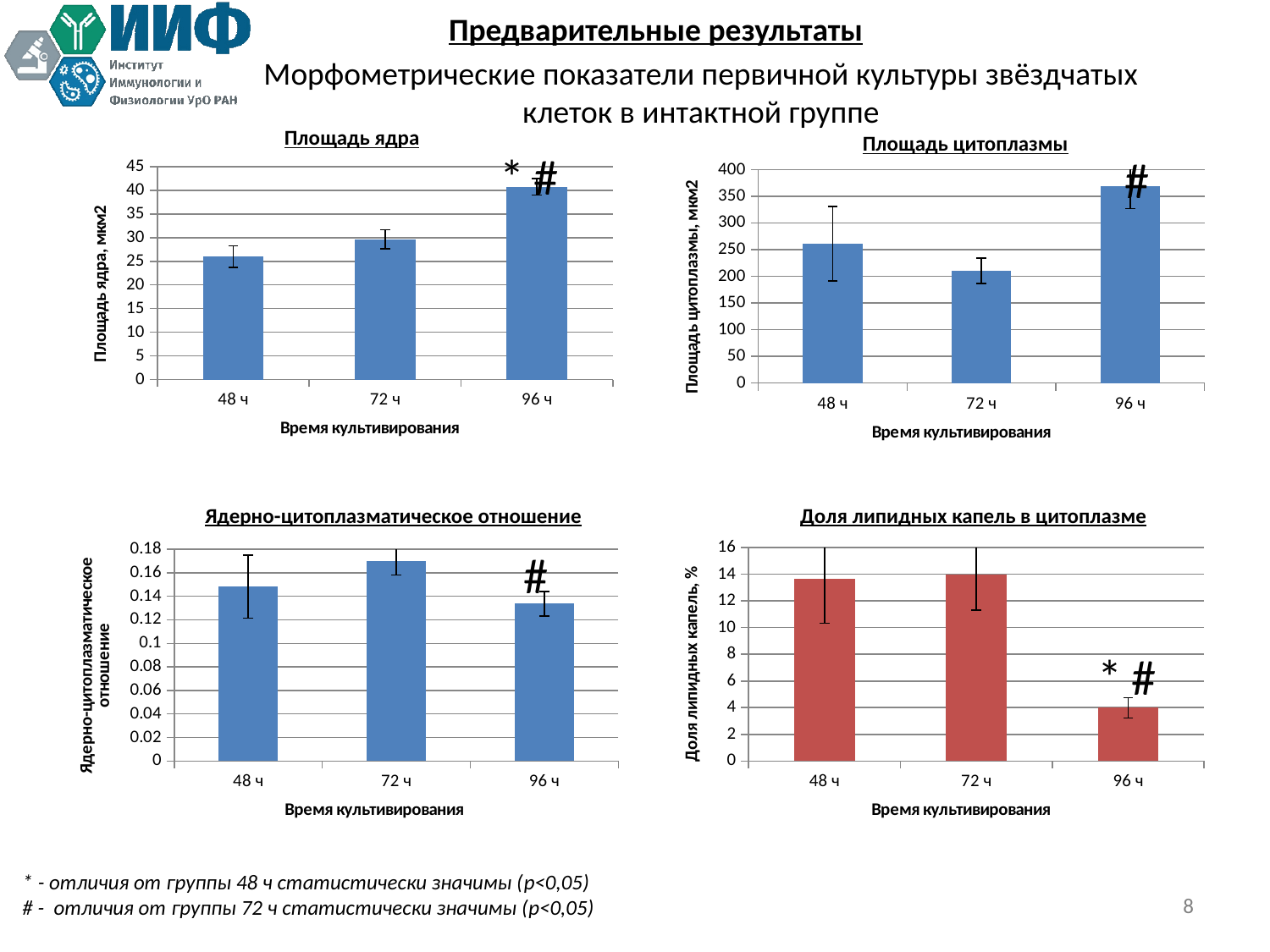
In the chart titled "Ядерно-цитоплазматическое отношение", is the value for 72 ч greater or less than 0.16? greater In the chart titled "Площадь ядра", is the value for 96 ч greater or less than 35? greater In the chart titled "Площадь цитоплазмы", which time point has the lowest value? 72 ч In the chart titled "Площадь ядра", which time point has the highest value? 96 ч In the chart titled "Ядерно-цитоплазматическое отношение", which time point has the highest value? 72 ч In the chart titled "Площадь цитоплазмы", which is larger, the value for 48 ч or the value for 72 ч? 48 ч In the chart titled "Доля липидных капель в цитоплазме", is the value for 96 ч greater or less than 6? less What kind of chart is the chart titled "Доля липидных капель в цитоплазме"? bar chart How many time points are shown on the x axis of the chart titled "Площадь ядра"? 3 In the chart titled "Доля липидных капель в цитоплазме", which time point has the lowest value? 96 ч In the chart titled "Площадь ядра", do the values rise or fall from 48 ч to 96 ч? rise